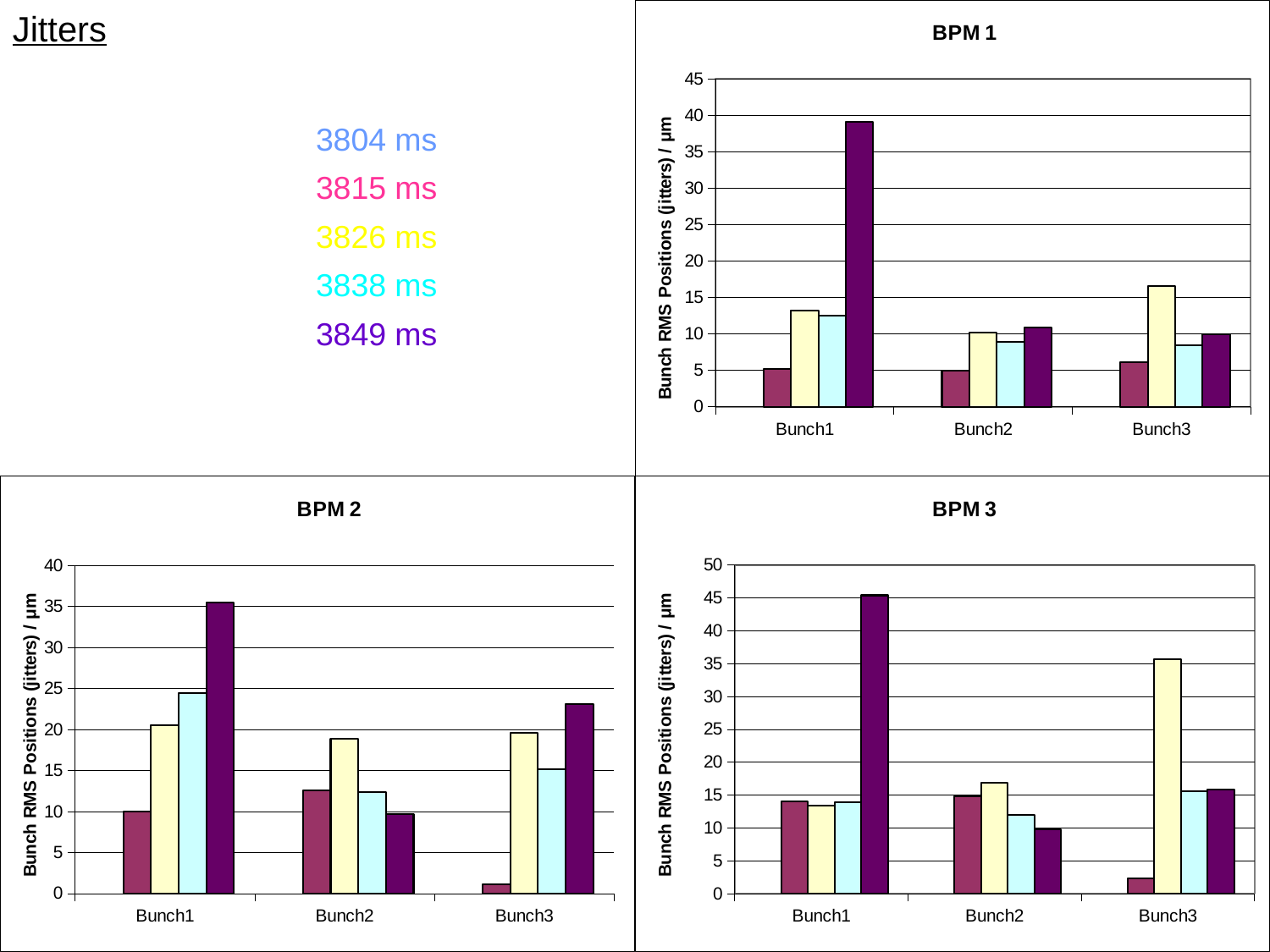
In the BPM 2 chart, is the tallest bar for Bunch3 greater or less than 20? greater How many bars are plotted for each bunch in the BPM 1 chart? 4 What kind of chart is the BPM 1 chart? bar chart In the BPM 3 chart, which bunch contains the tallest bar? Bunch1 How many categories are shown on the x axis of the BPM 2 chart? 3 In the BPM 2 chart, which bunch contains the shortest bar? Bunch3 In the BPM 3 chart, is the tallest bar for Bunch1 greater or less than 40? greater In the BPM 1 chart, is the tallest bar for Bunch1 greater or less than 35? greater In the BPM 1 chart, which bunch contains the tallest bar? Bunch1 In the BPM 3 chart, which has the taller maximum bar, Bunch1 or Bunch3? Bunch1 What is the y-axis label of the BPM 2 chart? Bunch RMS Positions (jitters) / µm